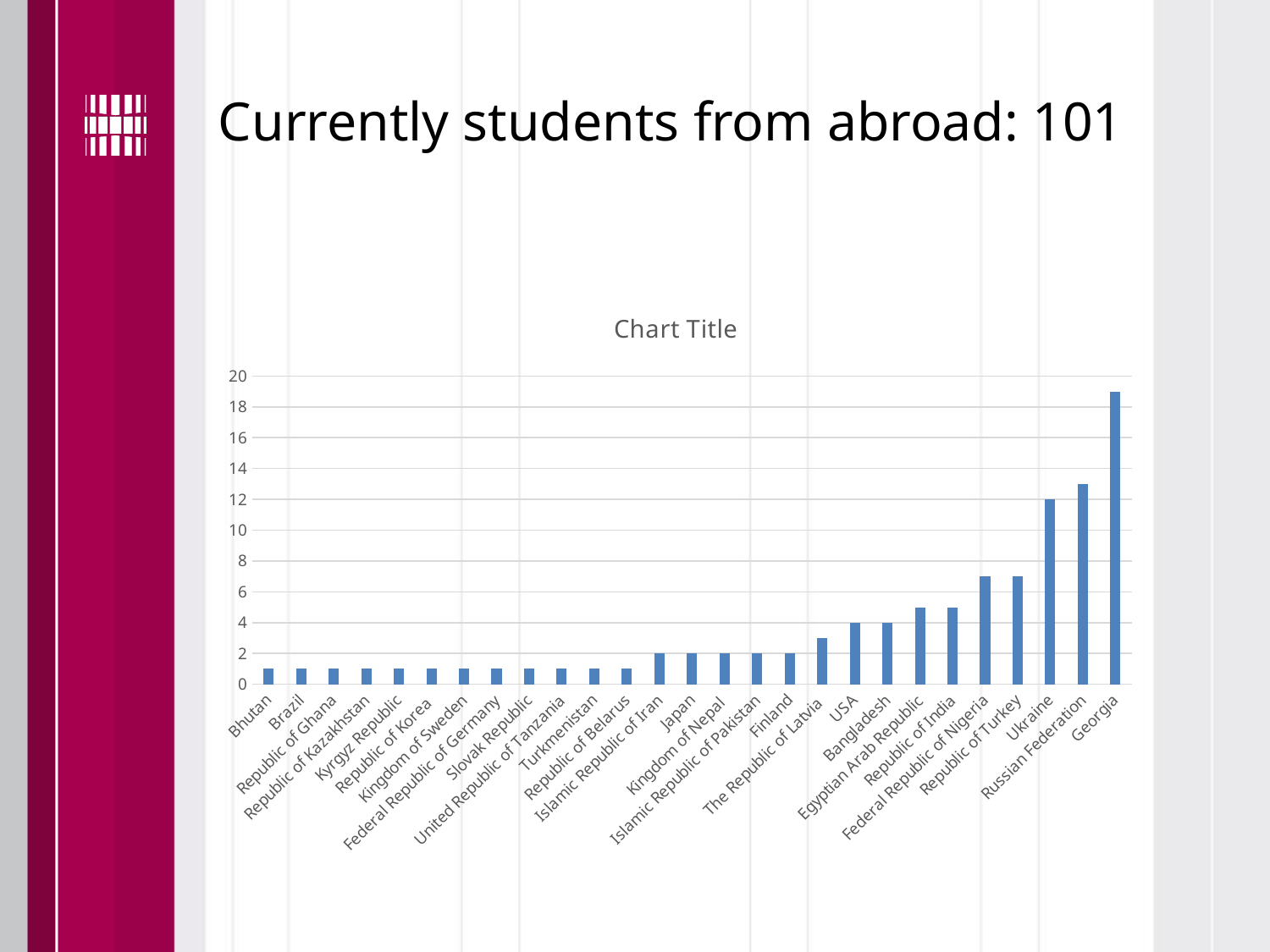
What is the value for Japan? 2 Which country has the highest bar in the chart? Georgia What kind of chart is shown on the slide? bar chart Is the value for Georgia greater or less than 18? greater Do the values generally rise or fall from left to right along the x axis? rise Is the value for Republic of Turkey greater or less than 8? less How many countries are shown on the x axis of the chart? 27 What is the difference between the values for Ukraine and USA? 8 Which has a larger value, Russian Federation or Ukraine? Russian Federation What is the value for Ukraine? 12 What is the value for USA? 4 What is the title printed above the chart? Chart Title